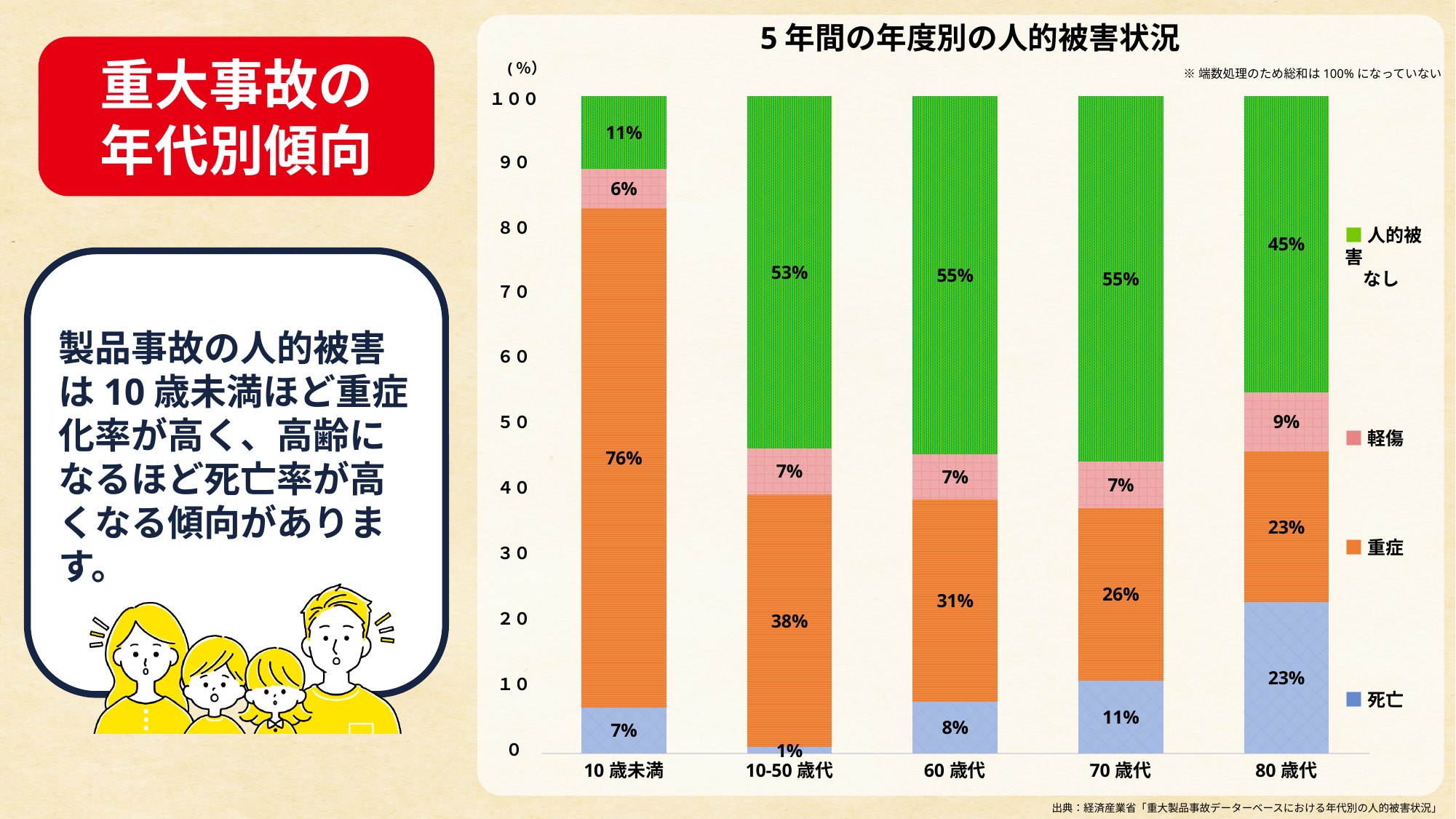
What is the 死亡 value for 80歳代? 23% What is the 軽傷 value for 70歳代? 7% Which age group has the lowest 死亡 value? 10-50歳代 Does the 死亡 value rise or fall from 10-50歳代 to 80歳代? Rise Which is larger, the 人的被害なし value for 60歳代 or for 80歳代? 60歳代 How many series does the legend list? 4 What is the 重症 value for 10歳未満? 76% What kind of chart is shown? Stacked bar chart How many age groups are shown on the x axis? 5 What is the difference between the 重症 values for 10歳未満 and 80歳代? 53% Which age group has the highest 死亡 value? 80歳代 What is the 人的被害なし value for 10-50歳代? 53%